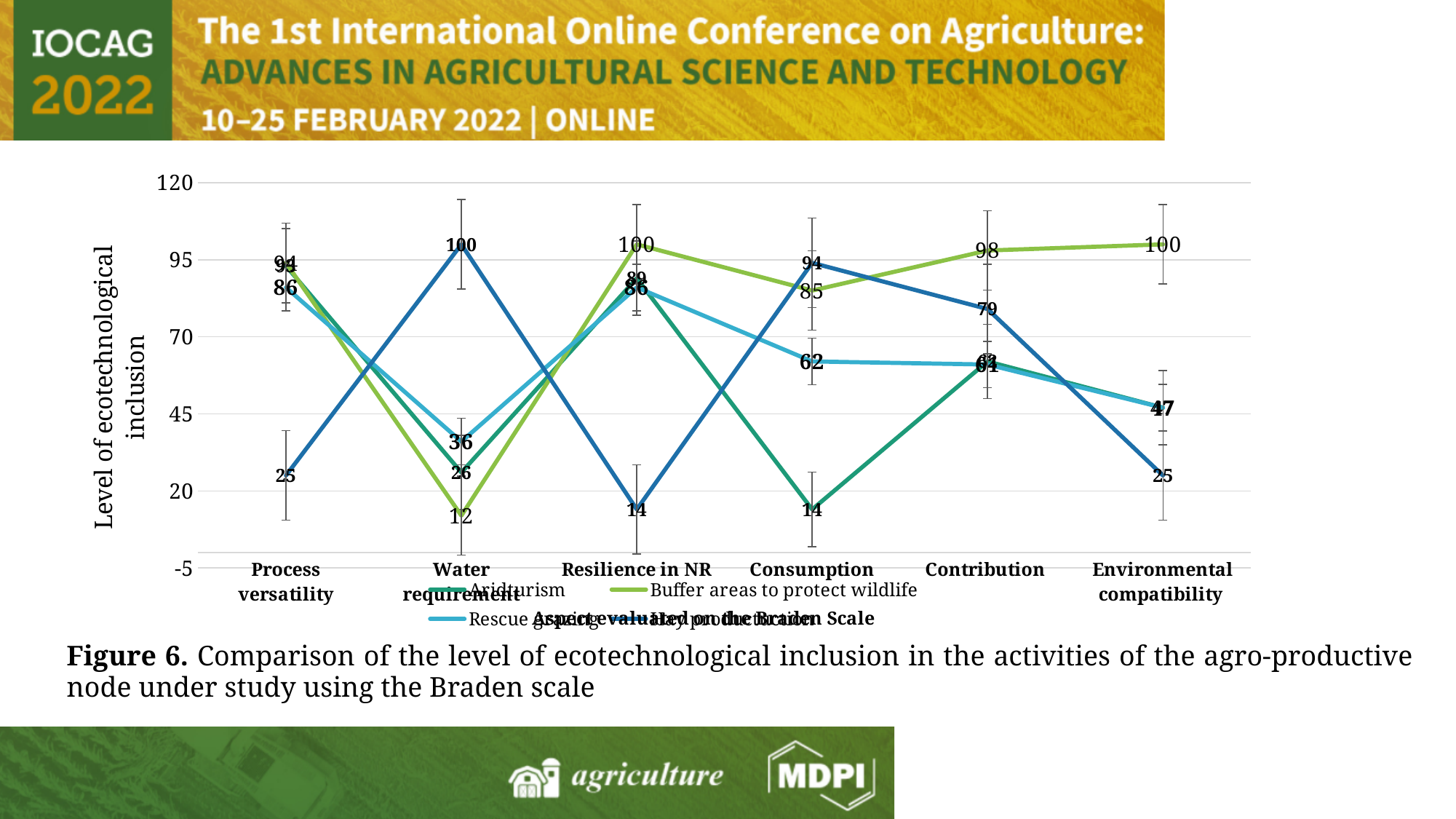
How many categories are shown on the x axis? 6 For Buffer areas to protect wildlife, which category has the lowest value? Water requirement What is the value for Buffer areas to protect wildlife at Contribution? 98 What is the difference between the Buffer areas to protect wildlife values at Process versatility and Water requirement? 82 What is the value for Buffer areas to protect wildlife at Water requirement? 12 For Buffer areas to protect wildlife, which is larger: the value at Consumption or at Contribution? Contribution What is the value for Aridturism at Water requirement? 26 What is the title of the y axis? Level of ecotechnological inclusion What is the value for Aridturism at Consumption? 14 Is the value for Aridturism at Consumption greater or less than 20? less What kind of chart is shown on the slide? line chart